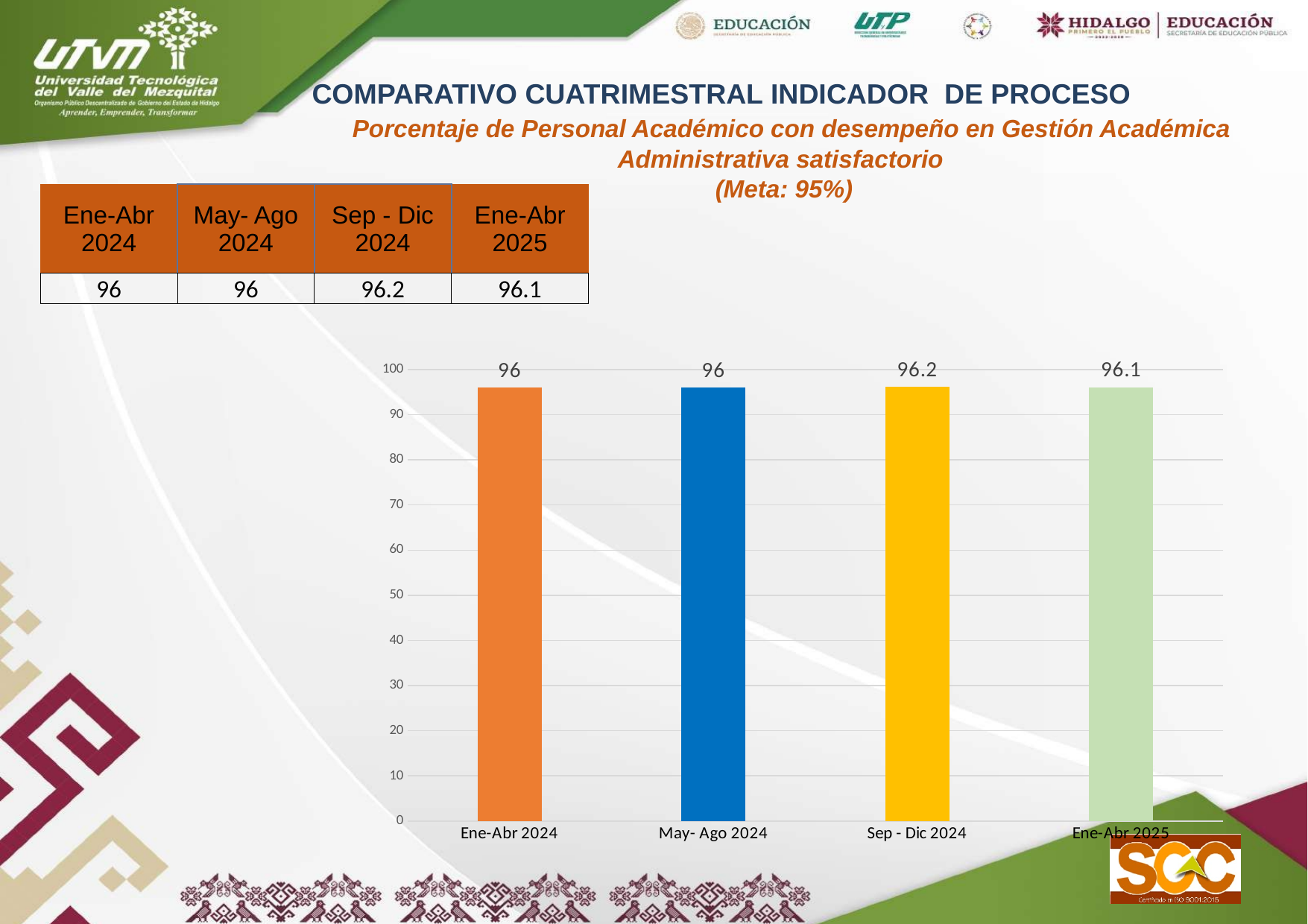
What is the target (Meta) stated in the chart subtitle? 95% What is the value for Ene-Abr 2024? 96 How many periods are shown on the x axis of the chart? 4 What is the value for Ene-Abr 2025? 96.1 What is the value for May- Ago 2024? 96 Which is larger, the value for Sep - Dic 2024 or the value for May- Ago 2024? Sep - Dic 2024 Which period has the highest value? Sep - Dic 2024 What is the difference between the values for Sep - Dic 2024 and Ene-Abr 2024? 0.2 What is the value for Sep - Dic 2024? 96.2 What is the difference between the values for Sep - Dic 2024 and Ene-Abr 2025? 0.1 What kind of chart is shown on the slide? bar chart Is the value for Ene-Abr 2025 greater or less than 90? greater